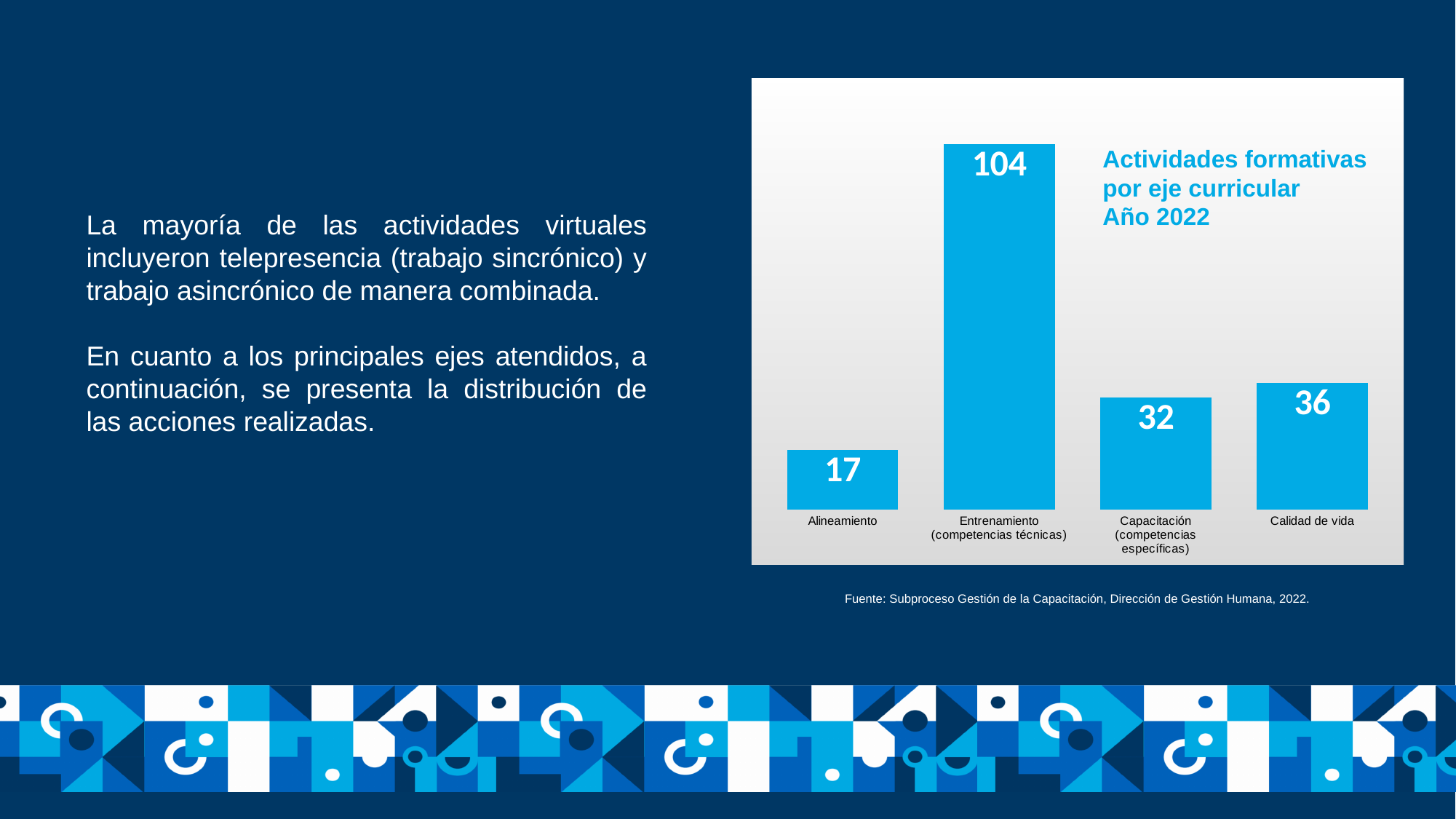
What is the title of the chart? Actividades formativas por eje curricular Año 2022 Which category has the highest value? Entrenamiento (competencias técnicas) Which category has the lowest value? Alineamiento What is the value for Alineamiento? 17 What is the value for Calidad de vida? 36 What is the difference between the values for Capacitación (competencias específicas) and Alineamiento? 15 Which is larger, the value for Calidad de vida or the value for Capacitación (competencias específicas)? Calidad de vida What kind of chart is shown on the slide? Bar chart How many categories are shown in the chart? 4 What is the value for Capacitación (competencias específicas)? 32 What is the value for Entrenamiento (competencias técnicas)? 104 What is the difference between the values for Entrenamiento (competencias técnicas) and Calidad de vida? 68